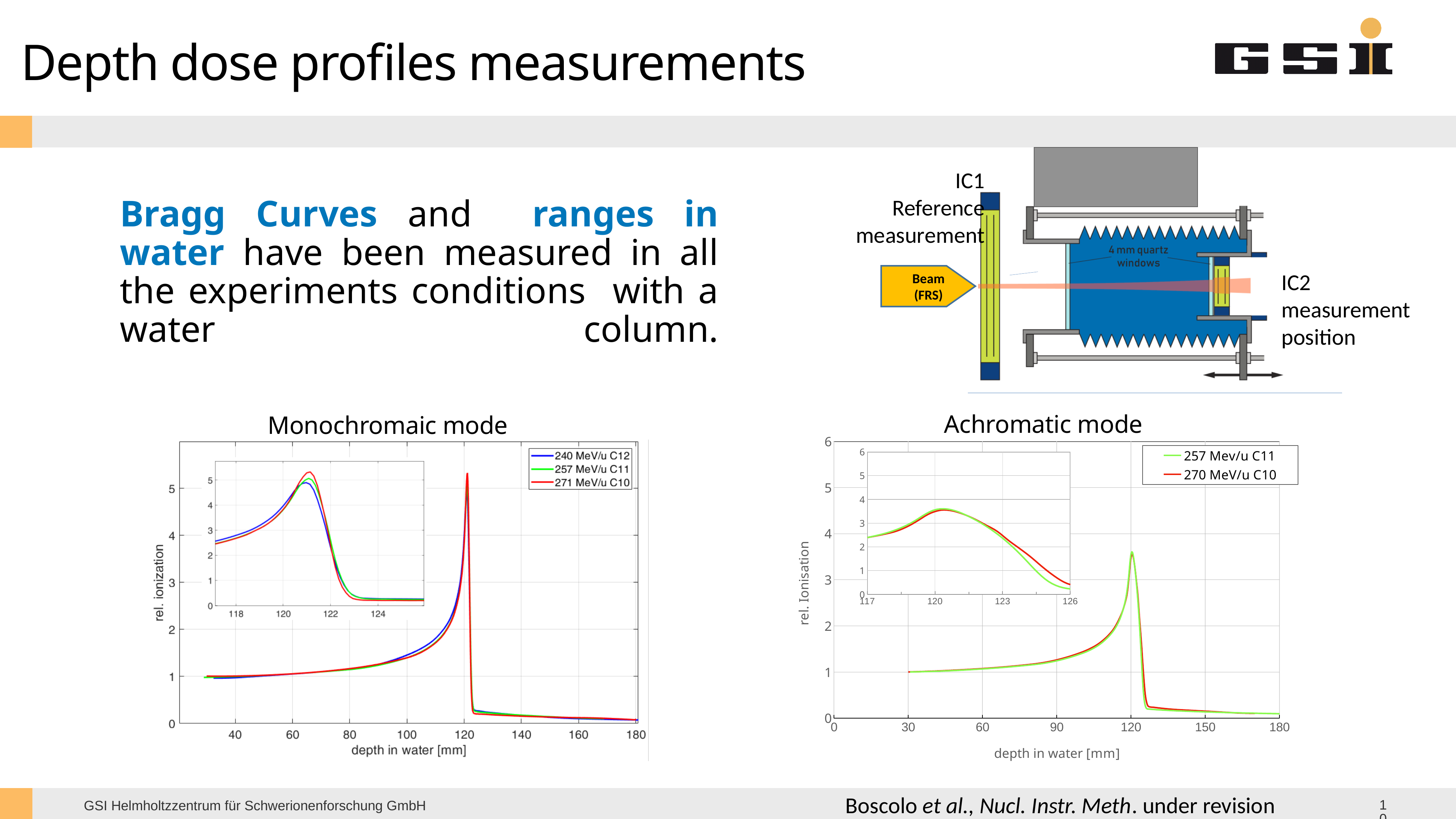
How many series does the legend of the Achromatic mode chart list? 2 In the Achromatic mode chart, do the curves rise or fall as depth increases from 130 mm to 180 mm? fall In the Achromatic mode chart, is the value at a depth of 60 mm greater or less than 2? less In the Monochromaic mode chart, is the value at a depth of 160 mm greater or less than 1? less In the Monochromaic mode chart, which series is drawn in blue? 240 MeV/u C12 What is the x-axis label of the Achromatic mode chart? depth in water [mm] In the Achromatic mode chart, is the peak value of the curves greater or less than 4? less How many series does the legend of the Monochromaic mode chart list? 3 What kind of chart is the Monochromaic mode chart? line chart In the Monochromaic mode chart, do the curves rise or fall as depth increases from 40 mm to 120 mm? rise